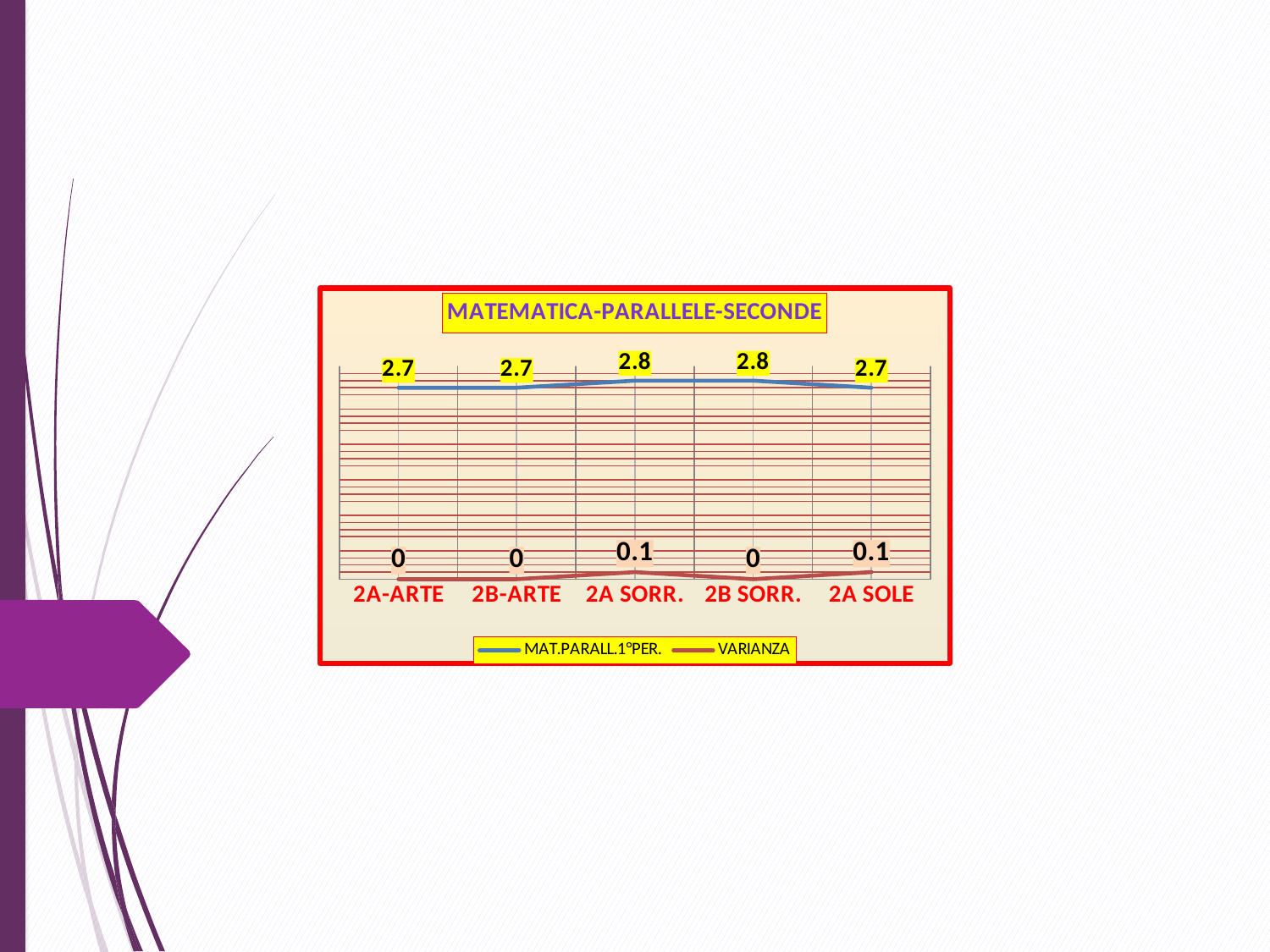
What type of chart is shown on the slide? line chart What is the MAT.PARALL.1°PER. value for 2A SORR.? 2.8 Which has the larger VARIANZA value, 2A SORR. or 2A-ARTE? 2A SORR. What is the MAT.PARALL.1°PER. value for 2A-ARTE? 2.7 How many series does the legend list? 2 How many categories are shown on the x axis? 5 What is the VARIANZA value for 2A SOLE? 0.1 Which series is drawn in blue according to the legend? MAT.PARALL.1°PER. What is the title of the chart? MATEMATICA-PARALLELE-SECONDE What is the difference between the MAT.PARALL.1°PER. values for 2B SORR. and 2A SOLE? 0.1 Which has the larger MAT.PARALL.1°PER. value, 2A SORR. or 2B-ARTE? 2A SORR. What is the VARIANZA value for 2B SORR.? 0